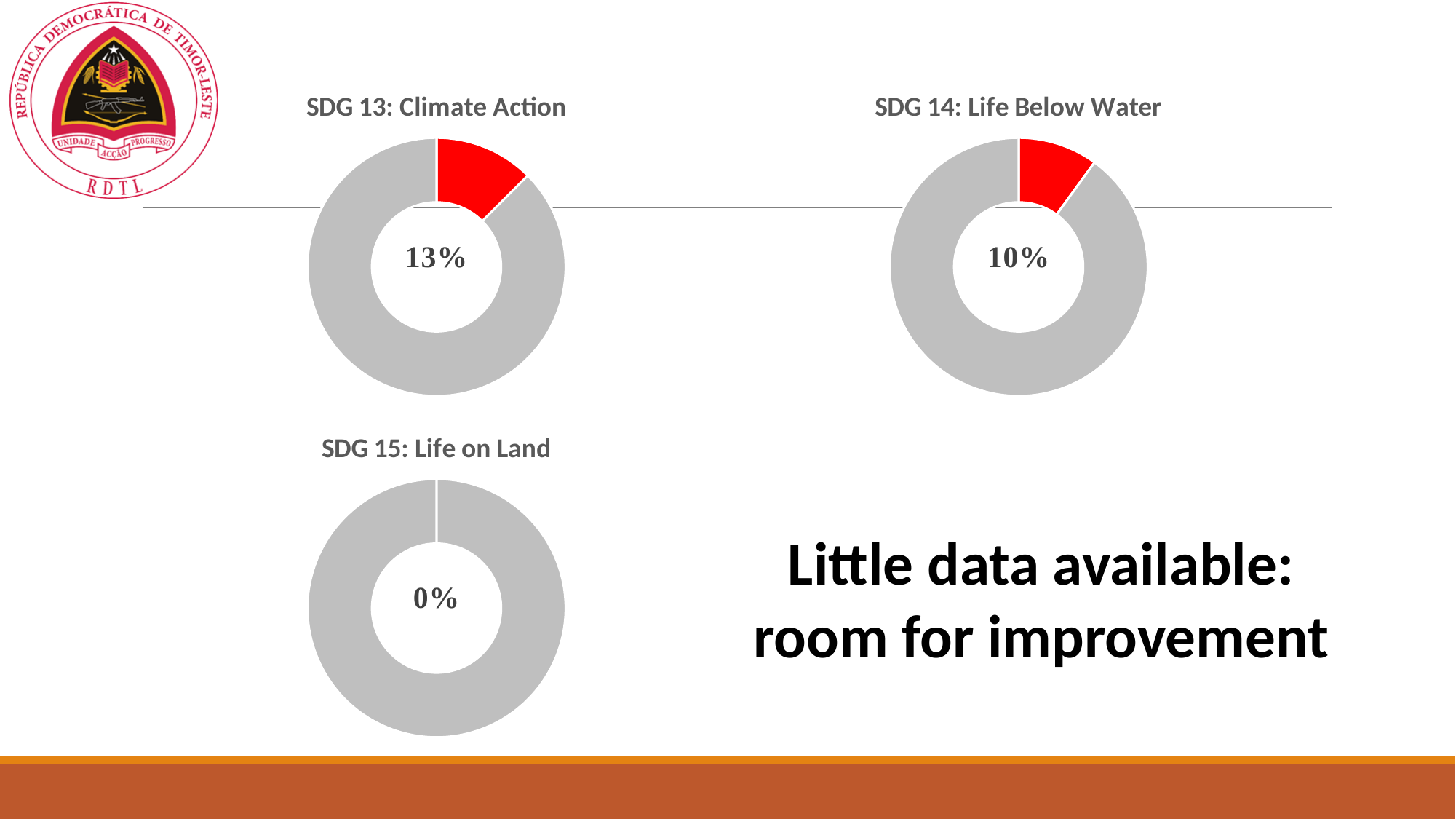
In the 'SDG 14: Life Below Water' chart, what percentage is shown in the centre of the doughnut? 10% What is the title of the chart in the bottom-left of the slide? SDG 15: Life on Land Across the three charts on the slide, which SDG has the lowest percentage? SDG 15: Life on Land In the 'SDG 13: Climate Action' chart, what share of the doughnut does the red slice represent? 13% Across the three charts on the slide, which SDG has the highest percentage? SDG 13: Climate Action In the 'SDG 15: Life on Land' chart, what percentage is shown in the centre of the doughnut? 0% In the 'SDG 13: Climate Action' chart, what colour is the slice representing the 13%? Red How many doughnut charts are shown on the slide? 3 What is the difference between the percentage in the 'SDG 13: Climate Action' chart and the percentage in the 'SDG 14: Life Below Water' chart? 3% What kind of chart is used for 'SDG 14: Life Below Water'? Doughnut chart Which is larger: the percentage in the 'SDG 13: Climate Action' chart or the percentage in the 'SDG 14: Life Below Water' chart? SDG 13: Climate Action In the 'SDG 13: Climate Action' chart, what percentage is shown in the centre of the doughnut? 13%